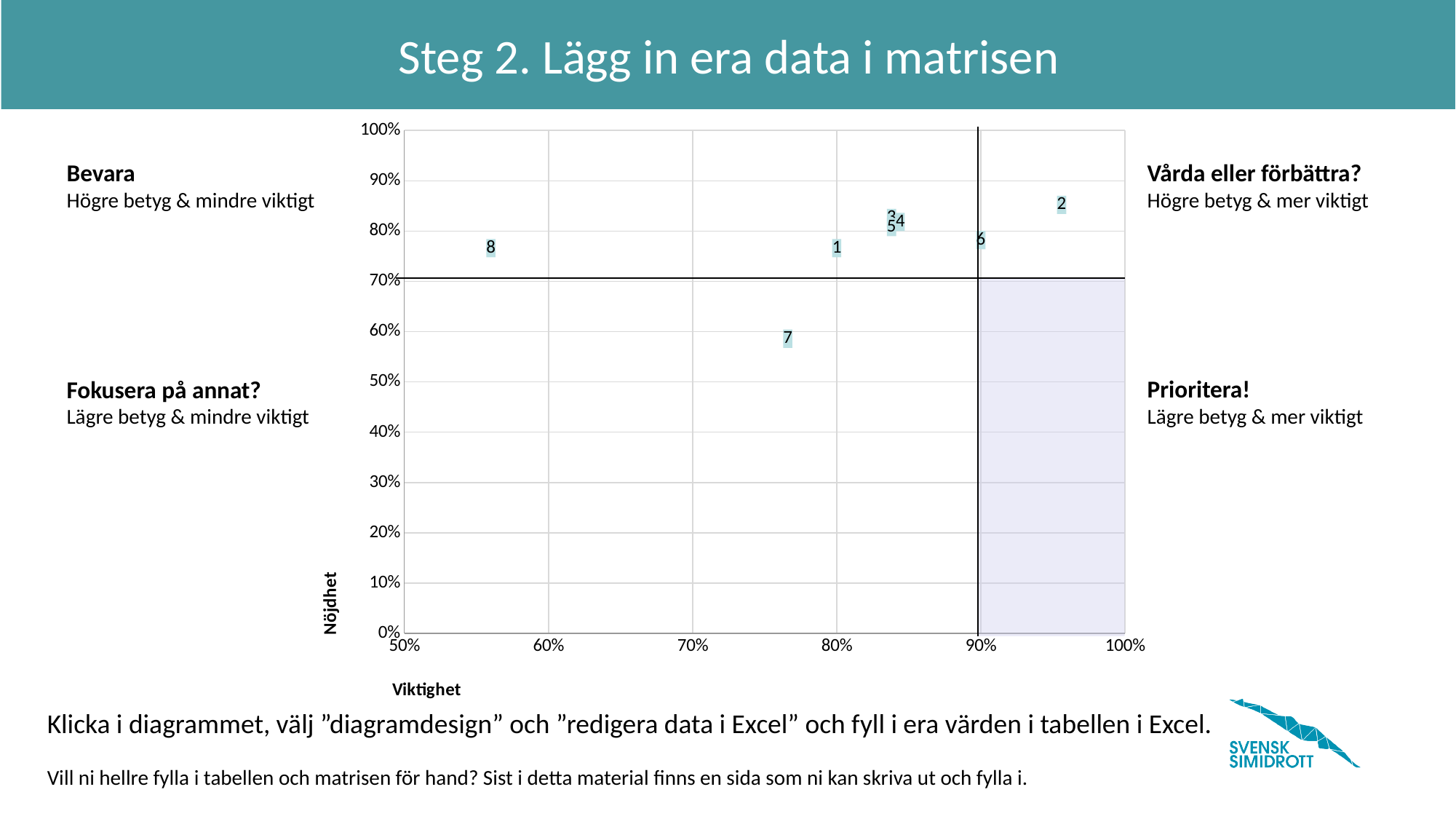
Is the Viktighet value for point 1 greater or less than 90%? less Which point has the lowest Nöjdhet value? 7 Which point has the higher Nöjdhet value, point 1 or point 7? 1 What is the label of the vertical axis of the chart? Nöjdhet Which point has the highest Viktighet value? 2 Is the Viktighet value for point 8 greater or less than 60%? less What is the label of the horizontal axis of the chart? Viktighet Which point has the lowest Viktighet value? 8 How many data points are plotted in the chart? 8 Is the Nöjdhet value for point 7 greater or less than 70%? less What kind of chart is shown on the slide? scatter chart